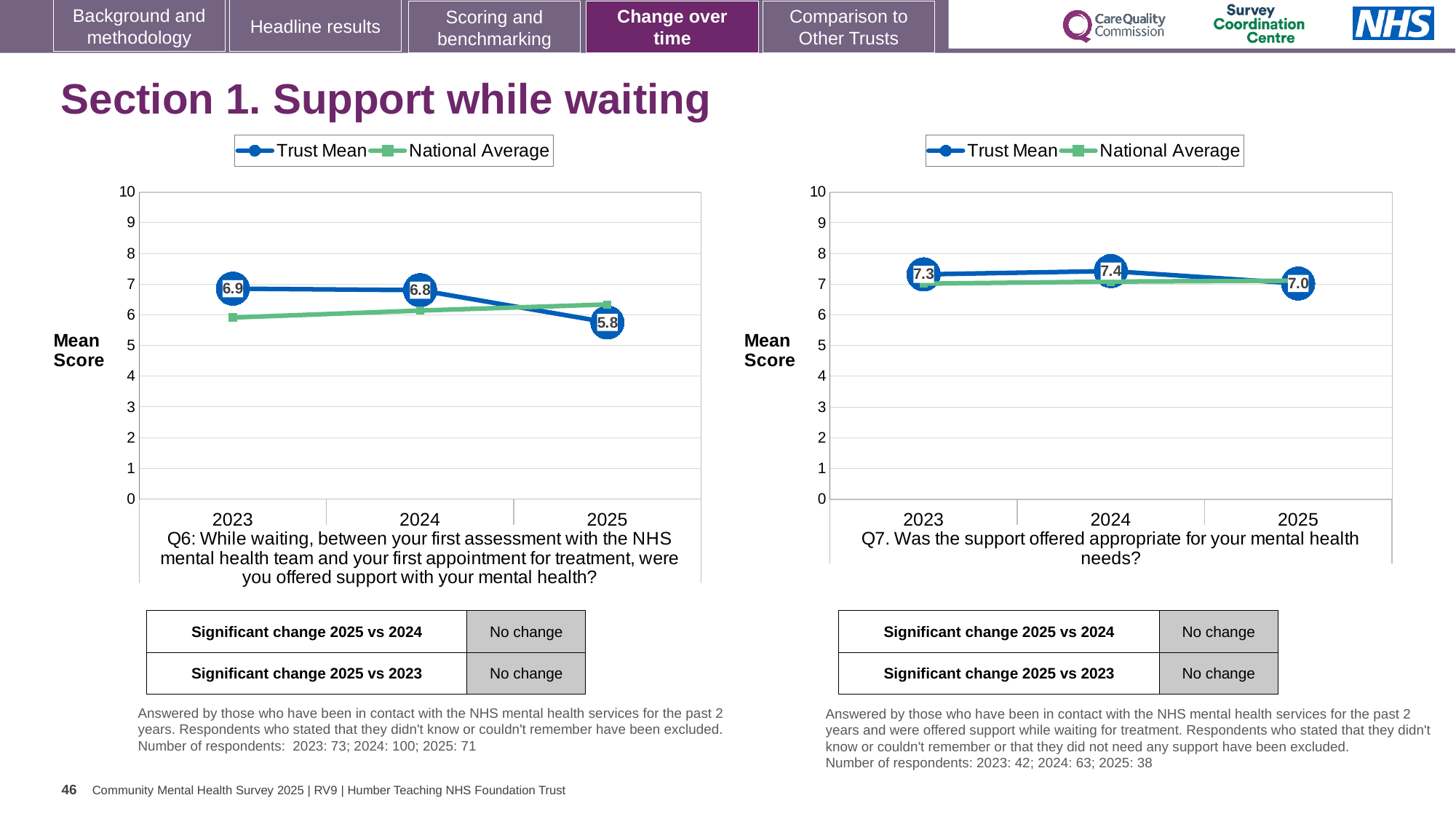
In the Q6 chart on the left, what is the difference between the Trust Mean scores for 2024 and 2025? 1.0 In the Q6 chart on the left, is the National Average for 2025 greater or less than 6? greater What type of chart is the Q6 chart on the left? Line chart In the Q7 chart on the right, what is the Trust Mean score for 2025? 7.0 In the Q7 chart on the right, what is the Trust Mean score for 2024? 7.4 In the Q6 chart on the left, which year has the lowest Trust Mean score? 2025 In the Q6 chart on the left, what is the Trust Mean score for 2023? 6.9 How many series does the legend of the Q7 chart on the right list? 2 In the Q7 chart on the right, which year has the highest Trust Mean score? 2024 In the Q7 chart on the right, what is the difference between the Trust Mean scores for 2023 and 2025? 0.3 In the Q6 chart on the left, what is the Trust Mean score for 2025? 5.8 In the Q6 chart on the left, which is higher in 2025, the Trust Mean or the National Average? National Average